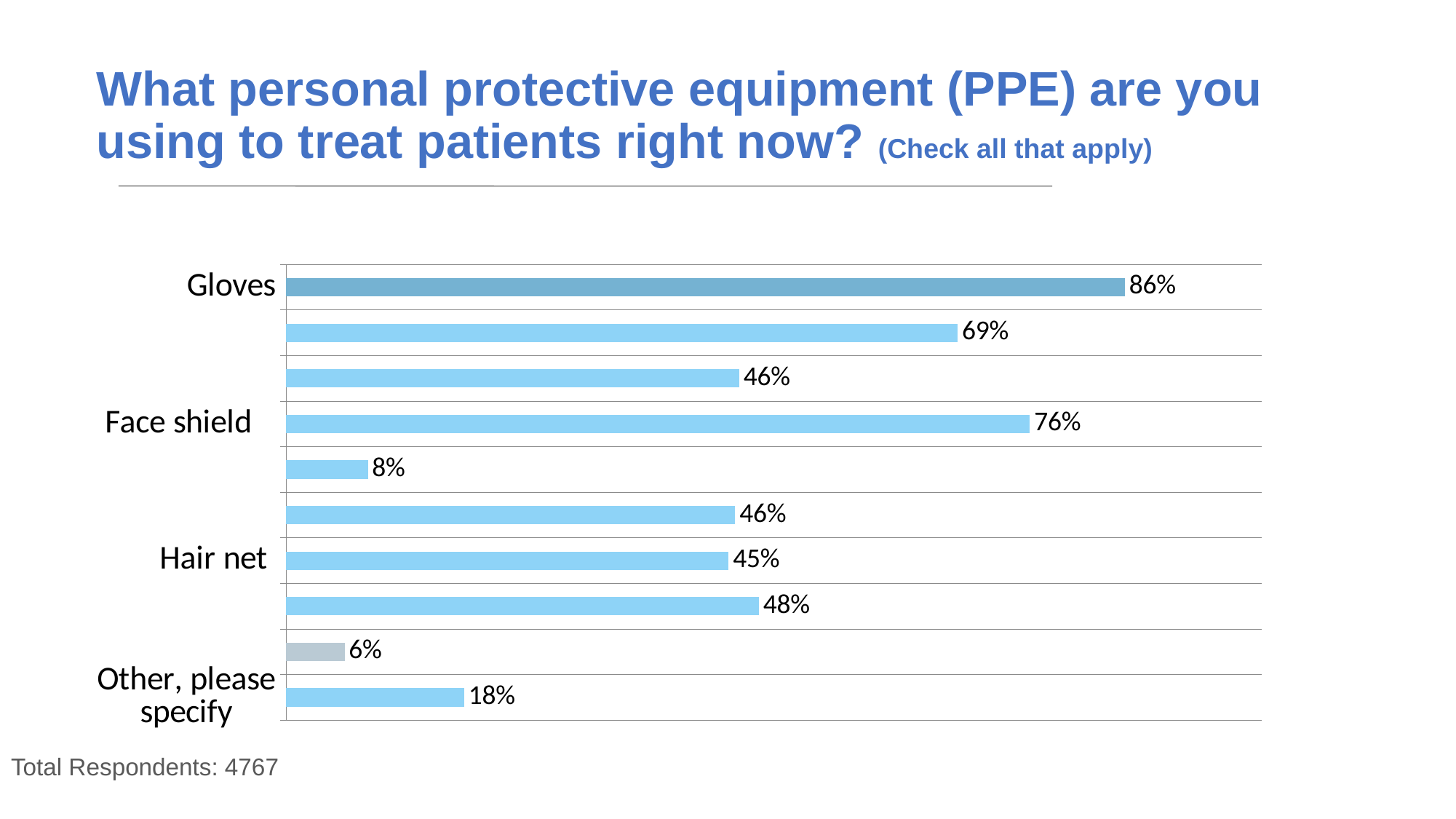
How many total respondents are noted below the chart? 4767 What is the value for the 'Other, please specify' category? 18% What is the difference in percentage points between Gloves and Face shield? 10 percentage points How many bars are plotted in the chart? 10 What percentage of respondents reported using gloves? 86% Which labelled category's bar is drawn in a darker blue than the others? Gloves What is the value shown for Face shield? 76% What type of chart is shown on the slide? Bar chart What percentage is shown for Hair net? 45% Which labelled category has the highest value in the chart? Gloves What is the smallest value printed on any bar in the chart? 6% Which is larger, the value for Face shield or the value for Hair net? Face shield